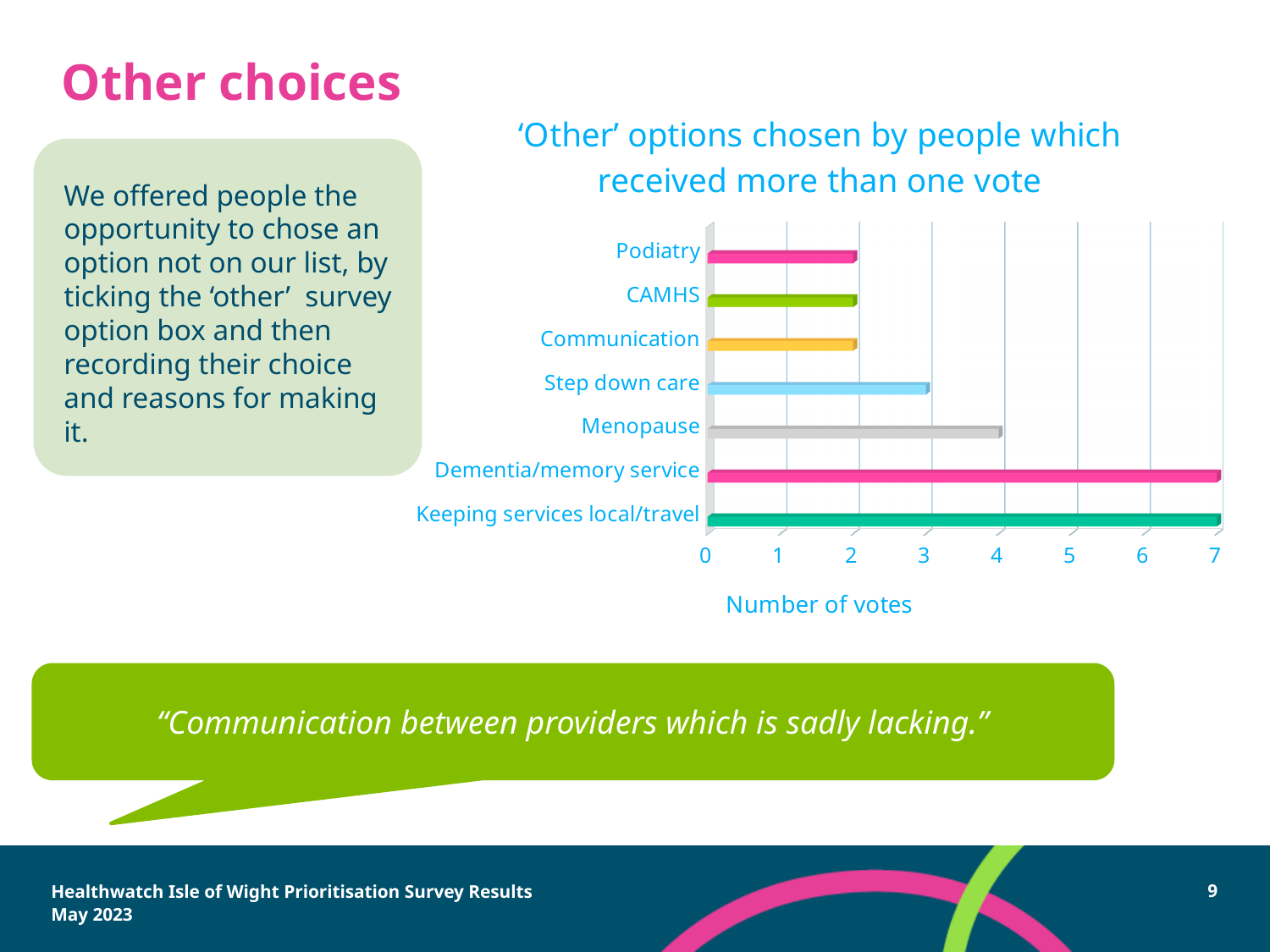
How many votes did Menopause receive? 4 Which received more votes, Menopause or Step down care? Menopause What is the label of the horizontal axis of the chart? Number of votes What kind of chart is shown on the slide? bar chart How many categories are plotted in the chart? 7 How many votes did Keeping services local/travel receive? 7 How many votes did Step down care receive? 3 How many votes did Dementia/memory service receive? 7 How many votes did Podiatry receive? 2 What is the title of the chart? 'Other' options chosen by people which received more than one vote What is the difference in votes between Menopause and Step down care? 1 Is the value for Dementia/memory service greater or less than 5? greater